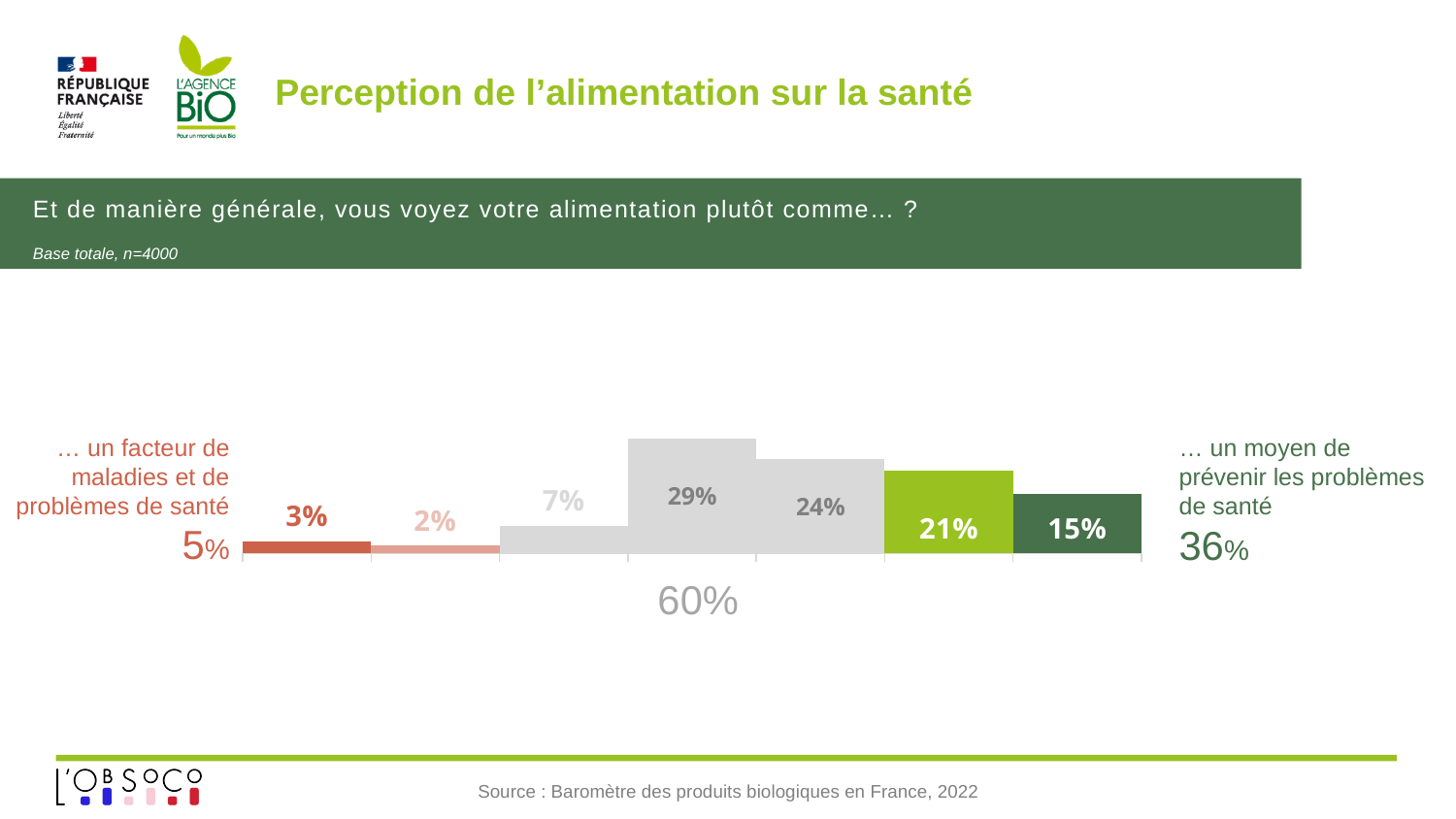
What total percentage is shown for the group labelled '… un moyen de prévenir les problèmes de santé'? 36% What is the difference between the 29% bar and the 24% bar next to it? 5% What total percentage is shown for the group labelled '… un facteur de maladies et de problèmes de santé'? 5% What is the value of the last bar on the right of the chart? 15% What is the value of the shortest bar in the chart? 2% Which is larger, the light green bar or the dark green bar? the light green bar (21%) How many bars are plotted in the chart? 7 What kind of chart is shown on the slide? bar chart What is the value of the light green bar? 21% What total percentage is shown for the grey bars in the middle of the chart? 60% What is the value of the tallest bar in the chart? 29% What is the value of the first bar on the left of the chart? 3%